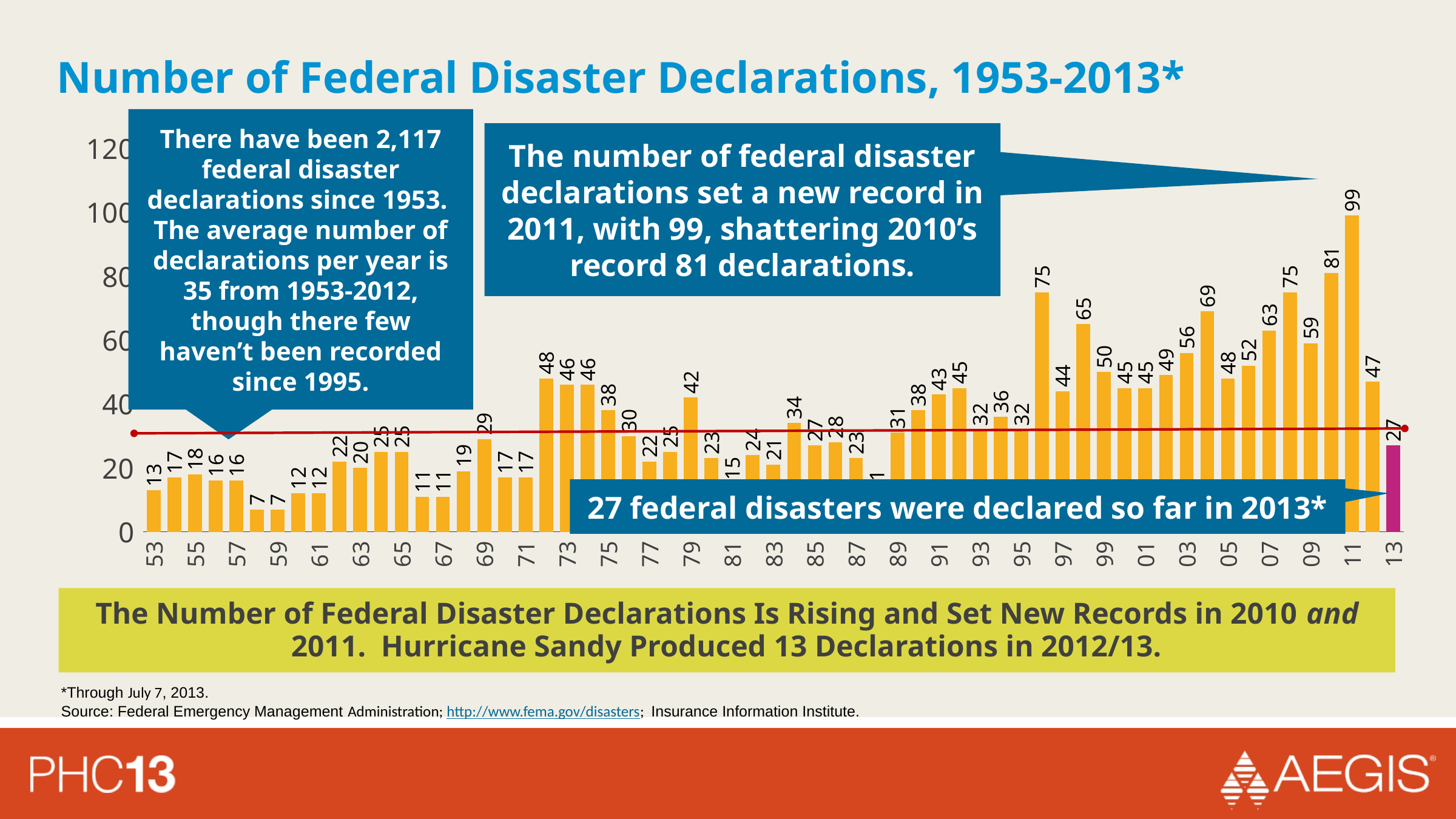
What colour is the bar for 2013, which differs from the other bars? Magenta (pink) Is the value for 2011 greater or less than 80? greater How many federal disaster declarations were there in 2011? 99 What kind of chart is shown on the slide? Bar chart What is the lowest number of declarations shown for any year in the chart? 7 What is the difference between the number of declarations in 2011 and in 2010? 18 Overall, do the number of federal disaster declarations rise or fall from 1953 to 2011? Rise Which year had the highest number of federal disaster declarations? 2011 What is the title of the chart? Number of Federal Disaster Declarations, 1953-2013* How many federal disaster declarations were there in 2010? 81 Which year had more federal disaster declarations, 2011 or 2010? 2011 How many federal disaster declarations were declared so far in 2013? 27